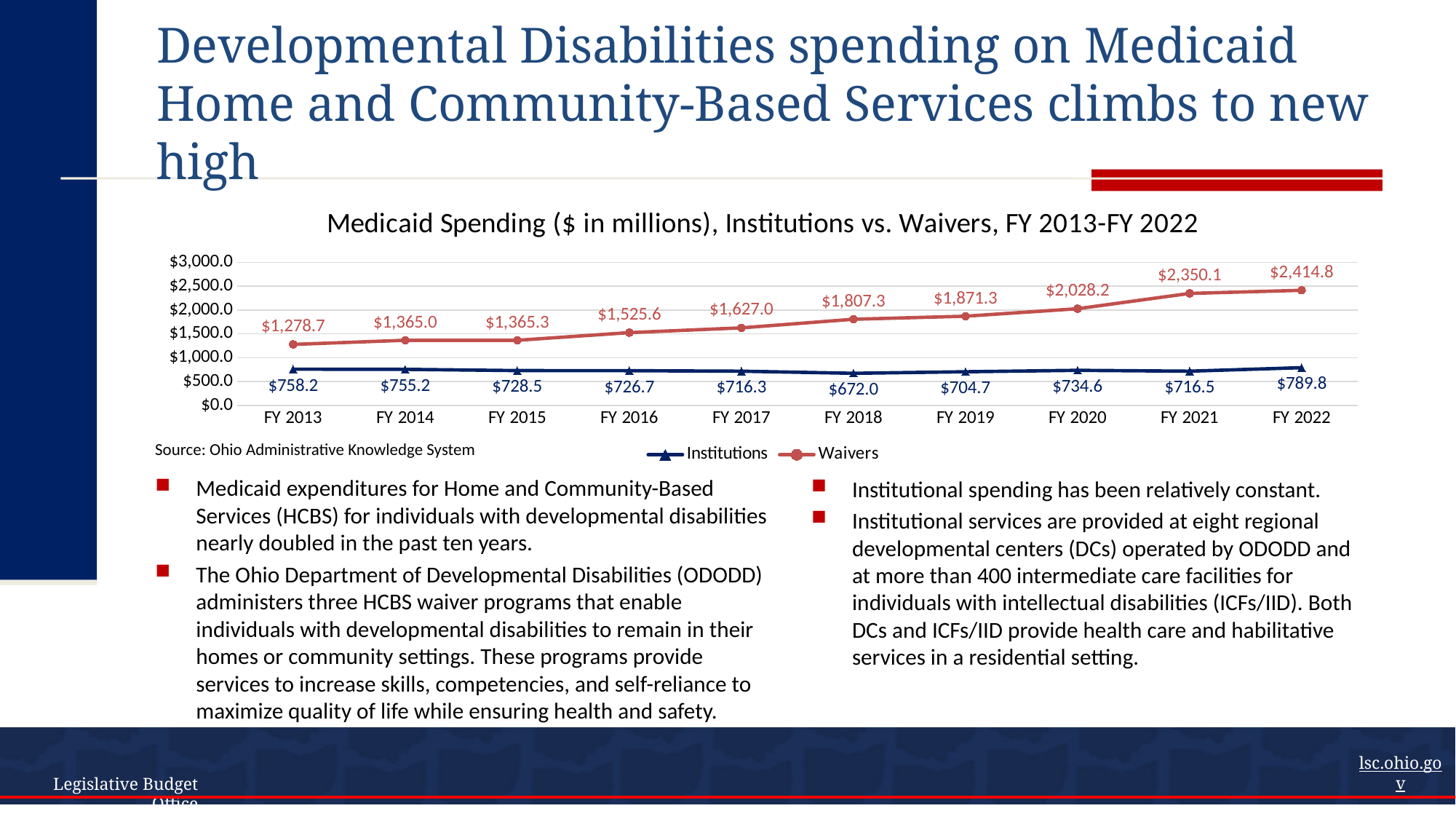
Which series had higher spending in FY 2016, Institutions or Waivers? Waivers In which fiscal year was Institutions spending the highest? FY 2022 What is the difference between Waivers and Institutions spending in FY 2022? $1,625.0 What kind of chart is shown on the slide? Line chart In which fiscal year was Institutions spending the lowest? FY 2018 In which fiscal year was Waivers spending the lowest? FY 2013 How many series does the legend list? 2 What was Medicaid spending on Waivers in FY 2022? $2,414.8 By how much did Waivers spending increase from FY 2013 to FY 2022? $1,136.1 How many fiscal years are plotted on the chart? 10 What was Medicaid spending on Institutions in FY 2018? $672.0 What was Medicaid spending on Waivers in FY 2013? $1,278.7